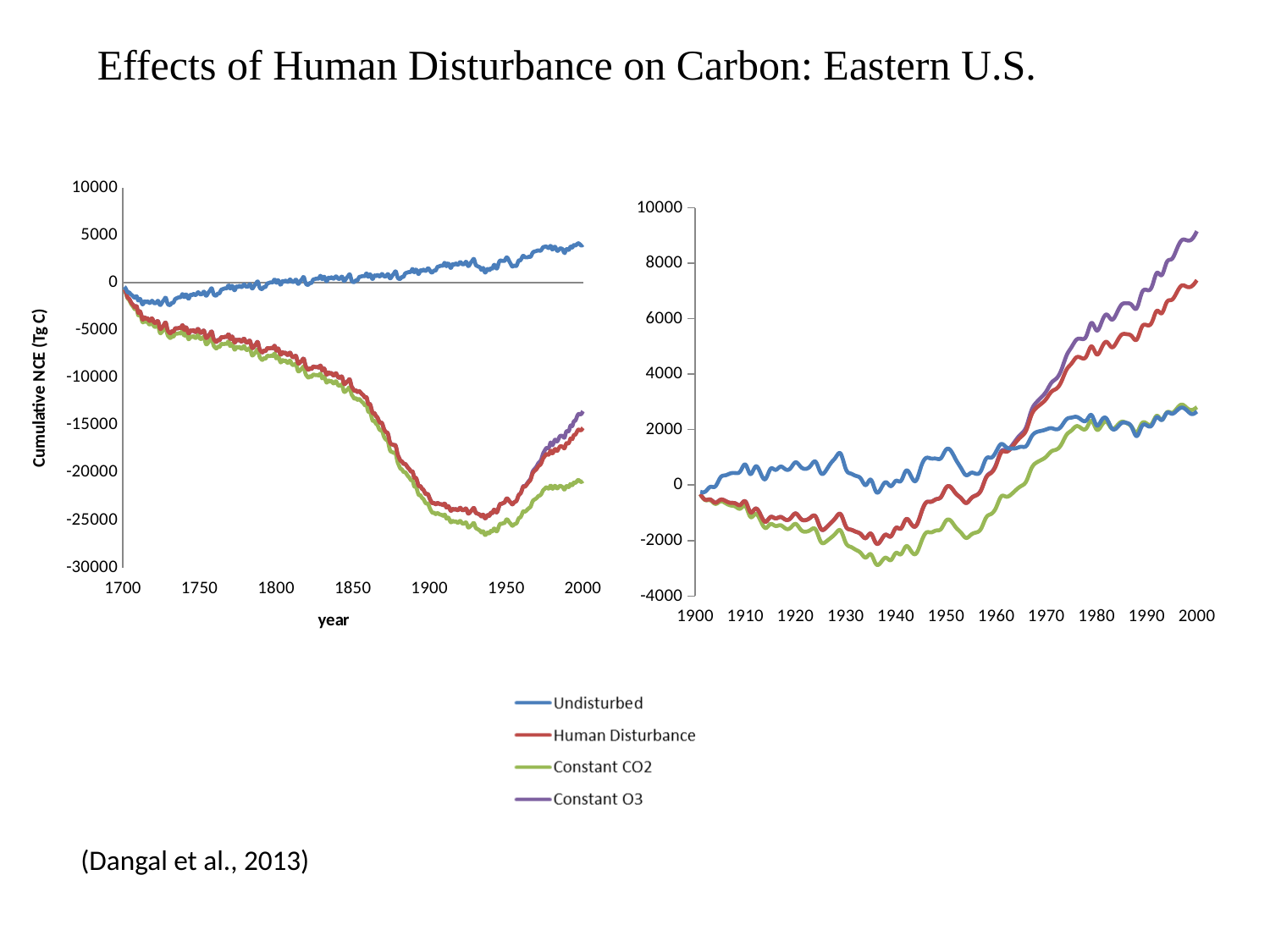
In the right chart (1900–2000), is the value of the Constant O3 line at 2000 greater or less than 8000? greater In the left chart (1700–2000), which series has the lowest value at 2000? Constant CO2 In the left chart (1700–2000), is the value of the Constant CO2 line at 2000 greater or less than -15000? less In the left chart (1700–2000), is the value of the Undisturbed line at 2000 greater or less than 0? greater In the right chart (1900–2000), which series has the highest value at 2000? Constant O3 What is the y-axis label of the left chart? Cumulative NCE (Tg C) What kind of chart is the left chart on the slide? line chart In the right chart (1900–2000), does the Constant O3 line rise or fall between 1960 and 2000? rise How many series does the legend list? 4